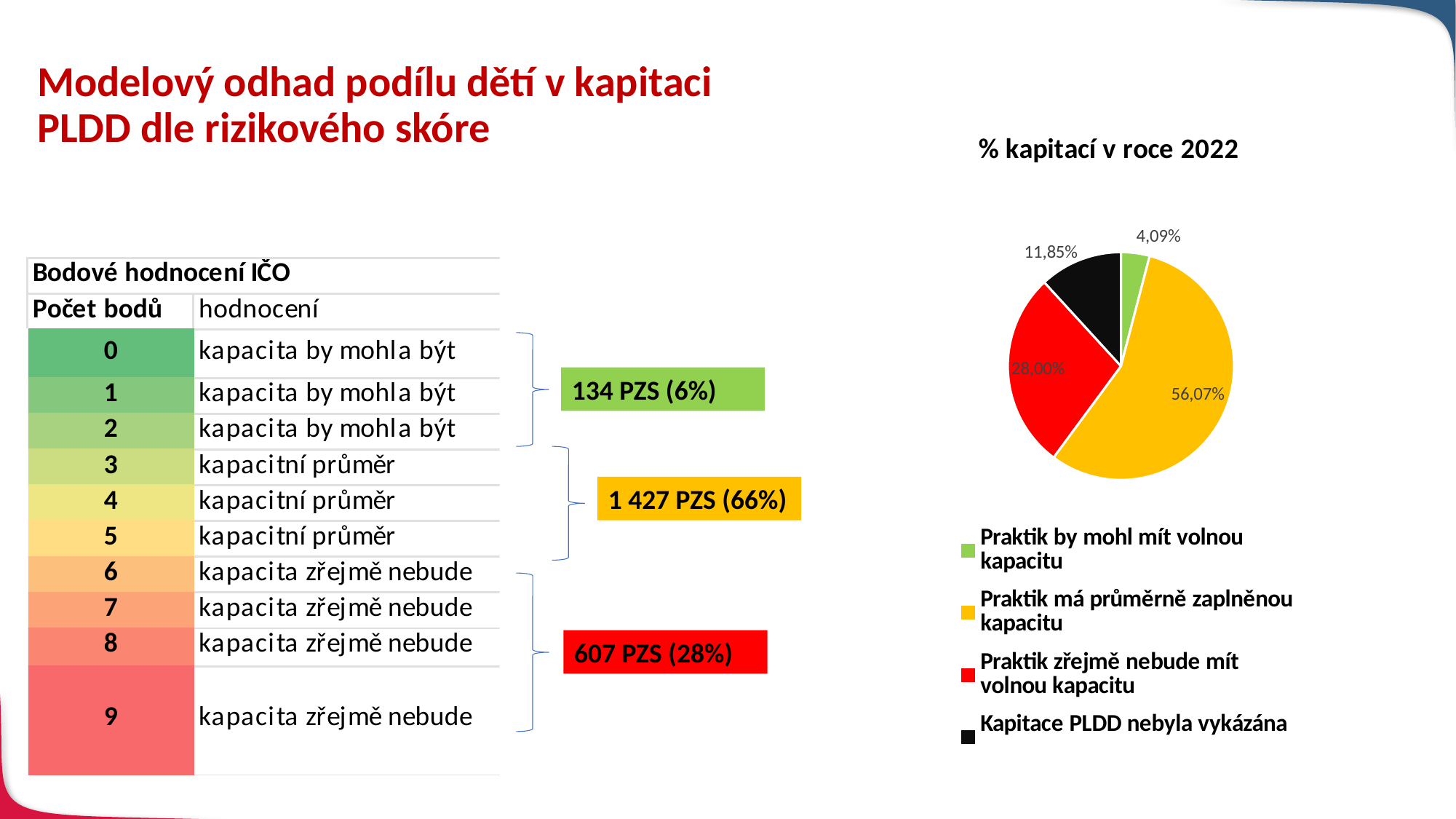
How many slices does the pie chart have? 4 Which category has the smallest slice of the pie? Praktik by mohl mít volnou kapacitu What is the title of the chart? % kapitací v roce 2022 What is the value for "Praktik by mohl mít volnou kapacitu"? 4,09% How many entries does the chart legend list? 4 What type of chart is shown on the slide? pie chart What is the difference between the values for "Praktik zřejmě nebude mít volnou kapacitu" and "Kapitace PLDD nebyla vykázána"? 16,15% What is the value for "Praktik zřejmě nebude mít volnou kapacitu"? 28,00% Which category has the largest slice of the pie? Praktik má průměrně zaplněnou kapacitu Which colour represents "Kapitace PLDD nebyla vykázána" in the pie chart? black What is the value for "Praktik má průměrně zaplněnou kapacitu"? 56,07% What is the value for "Kapitace PLDD nebyla vykázána"? 11,85%